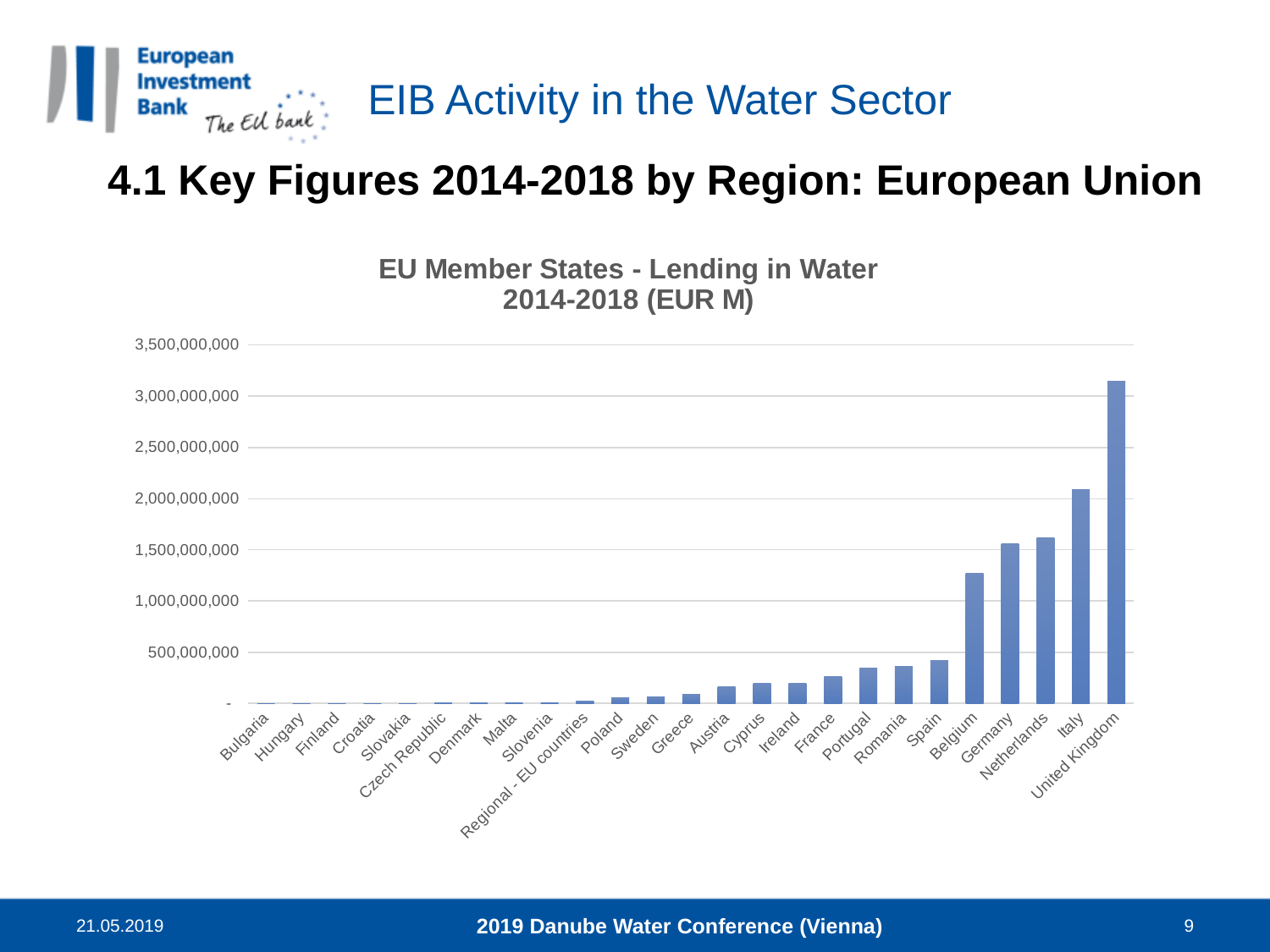
Which has a larger value, Belgium or Spain? Belgium Is the value for Italy greater or less than 2,500,000,000? less Is the value for Belgium greater or less than 1,000,000,000? greater What kind of chart is shown on the slide? Bar chart Is the value for United Kingdom greater or less than 3,000,000,000? greater Which category has the highest value in the chart? United Kingdom Which has a larger value, Italy or Germany? Italy Do the values generally rise or fall moving from left to right along the x axis? Rise What is the title of the chart? EU Member States - Lending in Water 2014-2018 (EUR M) How many categories are plotted on the x axis of the chart? 25